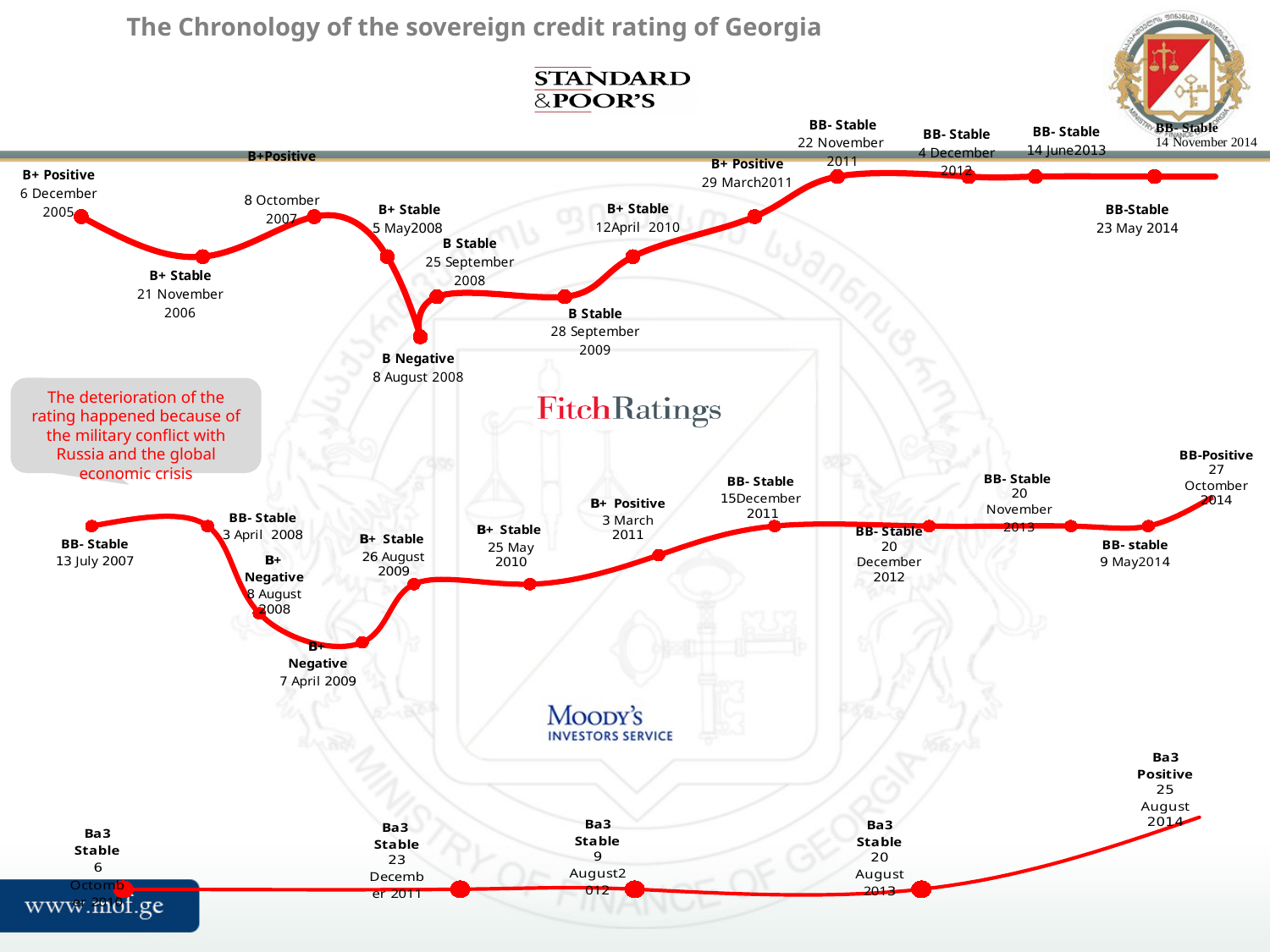
In the Fitch Ratings chart, what rating is shown for 27 October 2014? BB- Positive In the Moody's chart, what rating is shown for 25 August 2014? Ba3 Positive In the Moody's chart, does the line rise or fall toward August 2014? rises Which three rating agencies have charts on this slide? Standard & Poor's, Fitch Ratings, Moody's How many rating events are labelled in the Moody's chart? 5 In the Standard & Poor's chart, what rating is shown for 12 April 2010? B+ Stable In the Standard & Poor's chart, what is the date of the first rating point, labelled B+ Positive? 6 December 2005 In the Standard & Poor's chart, what rating is shown for 8 August 2008? B Negative In the Fitch Ratings chart, what rating is shown for 7 April 2009? B+ Negative What kind of chart is used to show the chronology of Georgia's sovereign credit rating on this slide? line chart In the Standard & Poor's chart, what rating is shown for 22 November 2011? BB- Stable In the Fitch Ratings chart, what rating is shown for 13 July 2007? BB- Stable